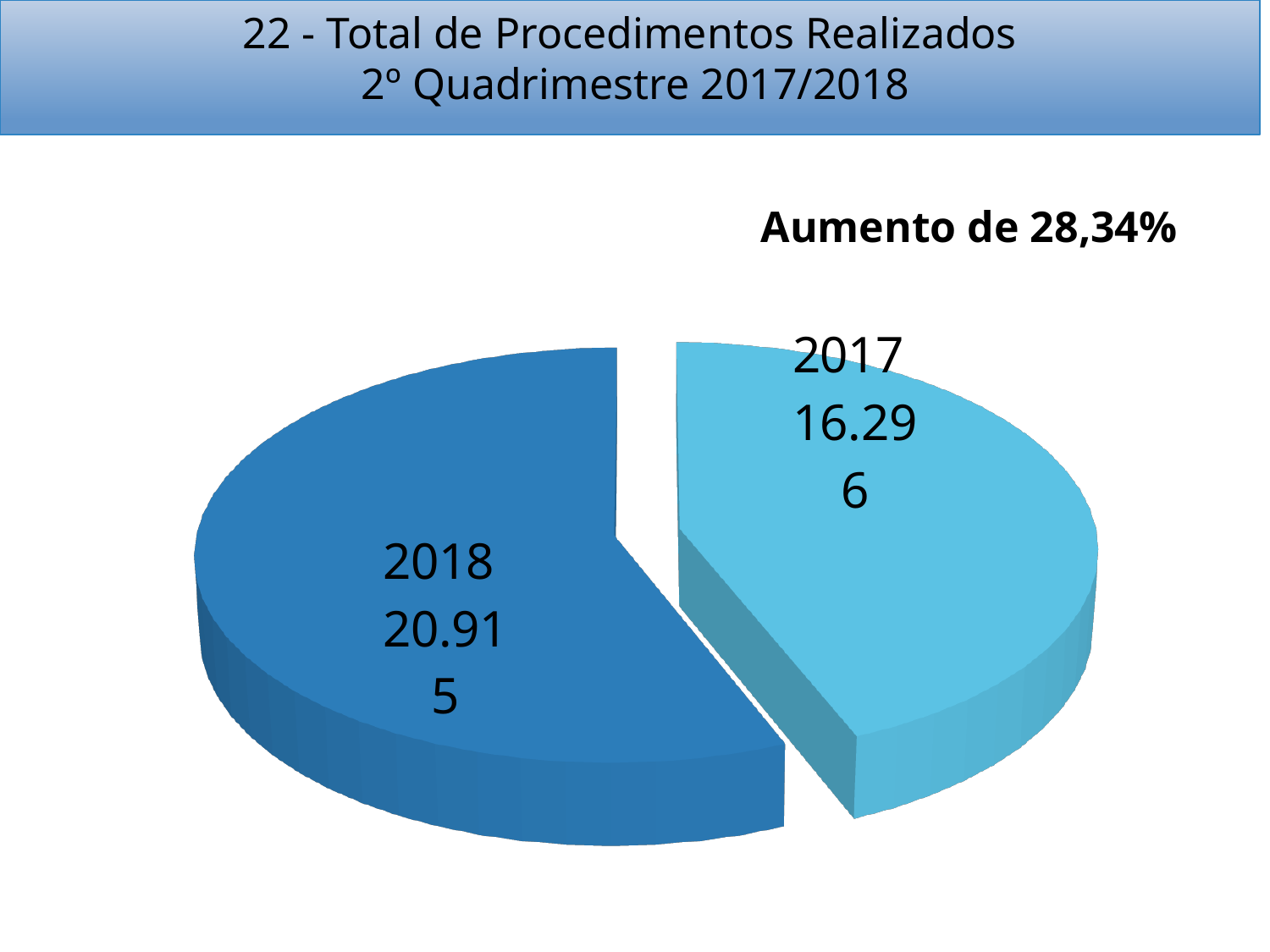
Is the value for 2018 larger or smaller than the value for 2017? Larger Which years are compared in the pie chart? 2017 and 2018 What is the difference between the 2018 value and the 2017 value? 4.619 How many slices does the pie chart have? 2 What is the value shown for 2017? 16.296 Which year has the larger slice of the pie? 2018 What type of chart is shown on the slide? Pie chart What is the total of the two slices in the pie chart? 37.211 Which year has the smaller slice of the pie? 2017 What is the value shown for 2018? 20.915 What is the title of the chart on the slide? 22 - Total de Procedimentos Realizados 2º Quadrimestre 2017/2018 What percentage increase is stated on the slide? 28,34%